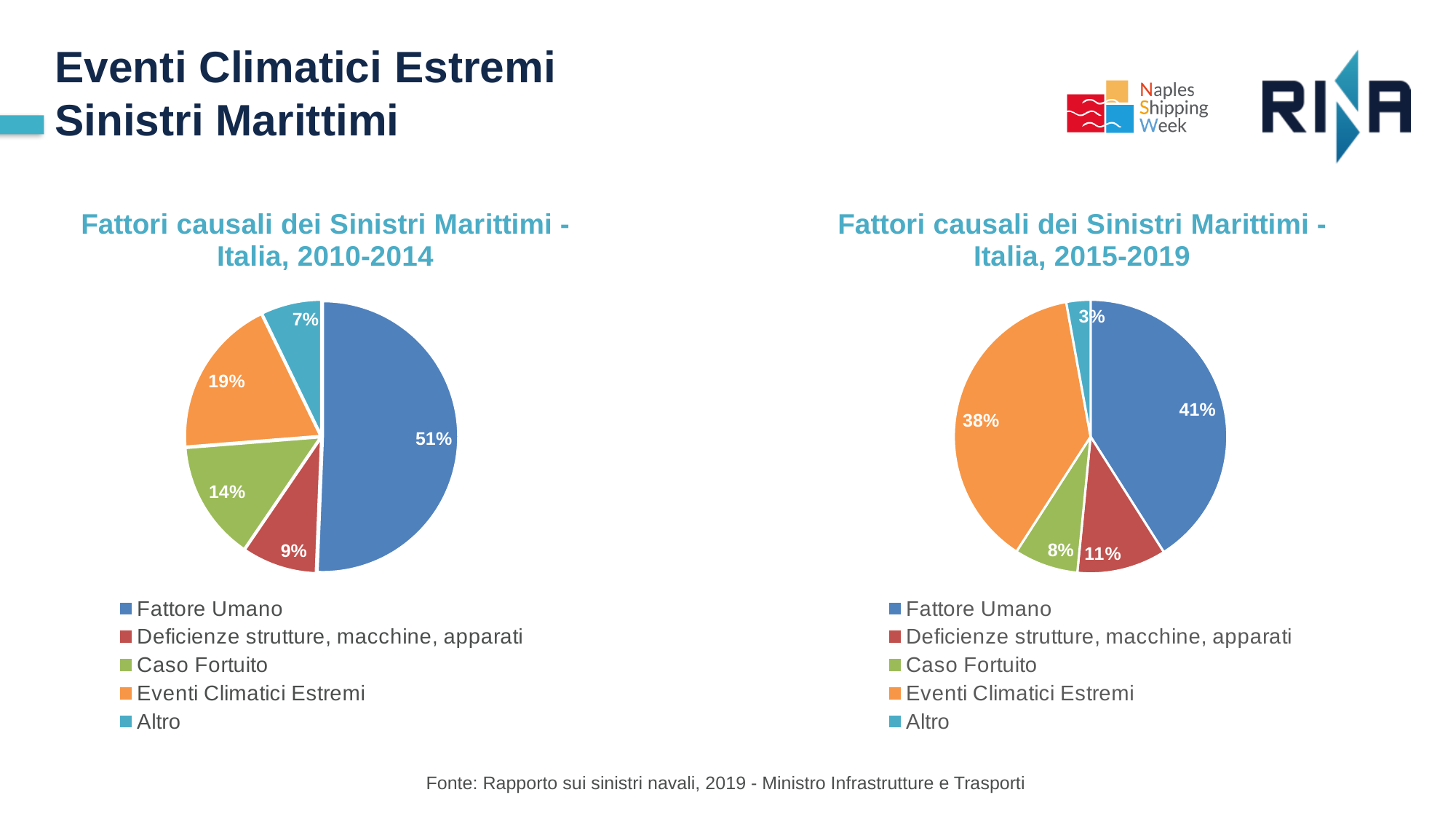
In the 'Fattori causali dei Sinistri Marittimi - Italia, 2015-2019' chart, which is larger: Deficienze strutture, macchine, apparati or Caso Fortuito? Deficienze strutture, macchine, apparati What kind of chart is the 'Fattori causali dei Sinistri Marittimi - Italia, 2015-2019' chart? Pie chart In the 'Fattori causali dei Sinistri Marittimi - Italia, 2015-2019' chart, what share does Eventi Climatici Estremi have? 38% In the 'Fattori causali dei Sinistri Marittimi - Italia, 2010-2014' chart, what share does Fattore Umano have? 51% In the 'Fattori causali dei Sinistri Marittimi - Italia, 2015-2019' chart, what share does Altro have? 3% How many categories does the 'Fattori causali dei Sinistri Marittimi - Italia, 2010-2014' chart show? 5 In the 'Fattori causali dei Sinistri Marittimi - Italia, 2010-2014' chart, what share does Caso Fortuito have? 14% In the 'Fattori causali dei Sinistri Marittimi - Italia, 2010-2014' chart, what share does Deficienze strutture, macchine, apparati have? 9% In the 'Fattori causali dei Sinistri Marittimi - Italia, 2010-2014' chart, what is the difference between the Fattore Umano share and the Eventi Climatici Estremi share? 32 percentage points In the 'Fattori causali dei Sinistri Marittimi - Italia, 2015-2019' chart, which category has the smallest slice? Altro In the 'Fattori causali dei Sinistri Marittimi - Italia, 2010-2014' chart, which category has the largest slice? Fattore Umano In the 'Fattori causali dei Sinistri Marittimi - Italia, 2015-2019' chart, which colour represents Eventi Climatici Estremi? Orange